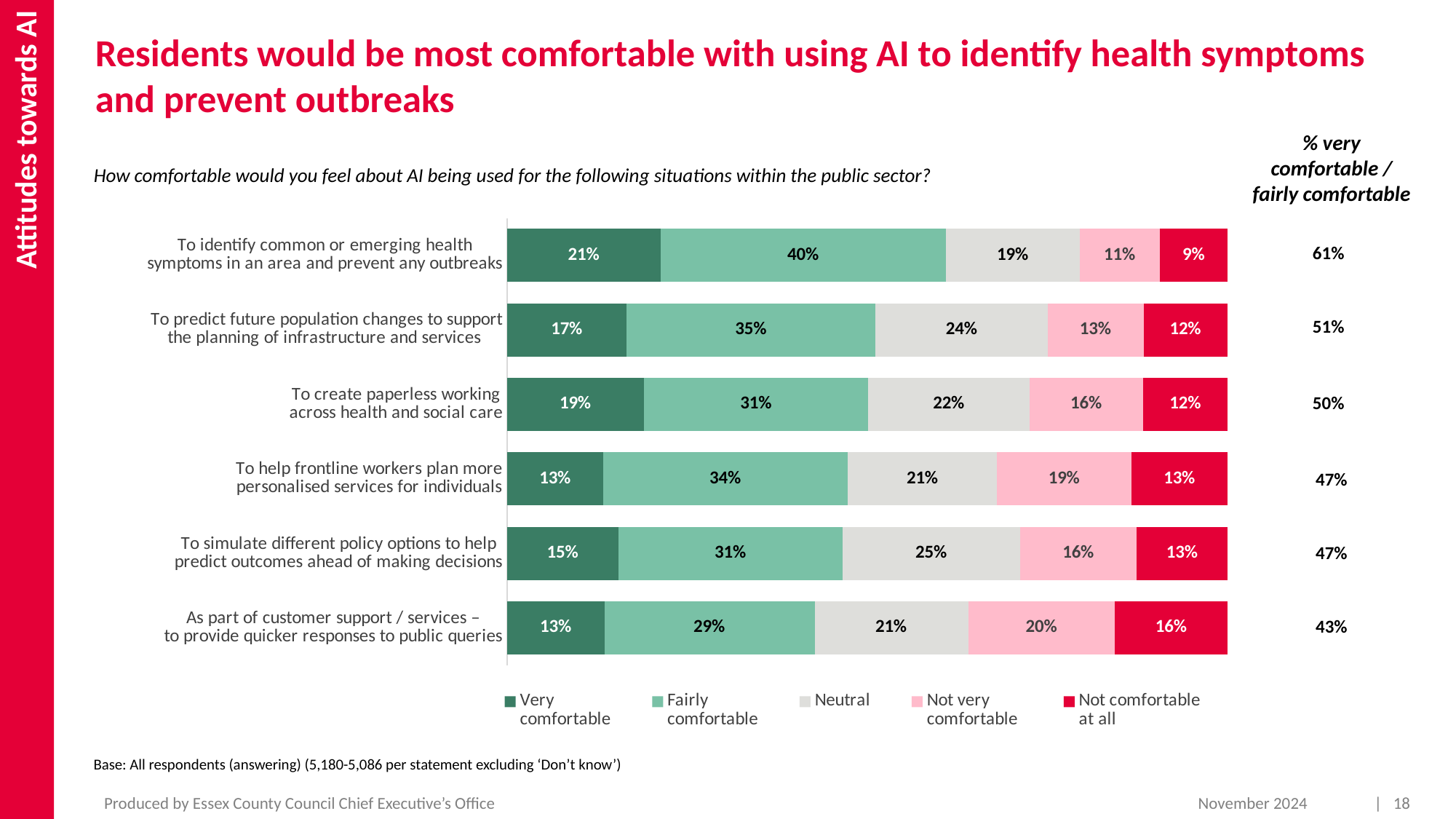
Which is larger: the 'Not very comfortable' value for 'To help frontline workers plan more personalised services for individuals' or for 'To predict future population changes to support the planning of infrastructure and services'? To help frontline workers plan more personalised services for individuals What kind of chart is shown on the slide? Stacked bar chart Which legend entry is shown in the darkest green colour? Very comfortable How many series does the legend list? 5 What is the difference between the 'Fairly comfortable' values for 'To identify common or emerging health symptoms' and 'To create paperless working across health and social care'? 9% What is the total of the stacked bar for 'To predict future population changes to support the planning of infrastructure and services'? 101% How many situations (categories) are shown in the chart? 6 Which situation has the lowest 'Fairly comfortable' value? As part of customer support / services – to provide quicker responses to public queries What is the 'Neutral' value for 'To simulate different policy options to help predict outcomes ahead of making decisions'? 25% What is the 'Not comfortable at all' value for 'As part of customer support / services – to provide quicker responses to public queries'? 16% What percentage of respondents are 'Very comfortable' with AI being used to identify common or emerging health symptoms in an area and prevent any outbreaks? 21% Which situation has the highest combined '% very comfortable / fairly comfortable' figure? To identify common or emerging health symptoms in an area and prevent any outbreaks